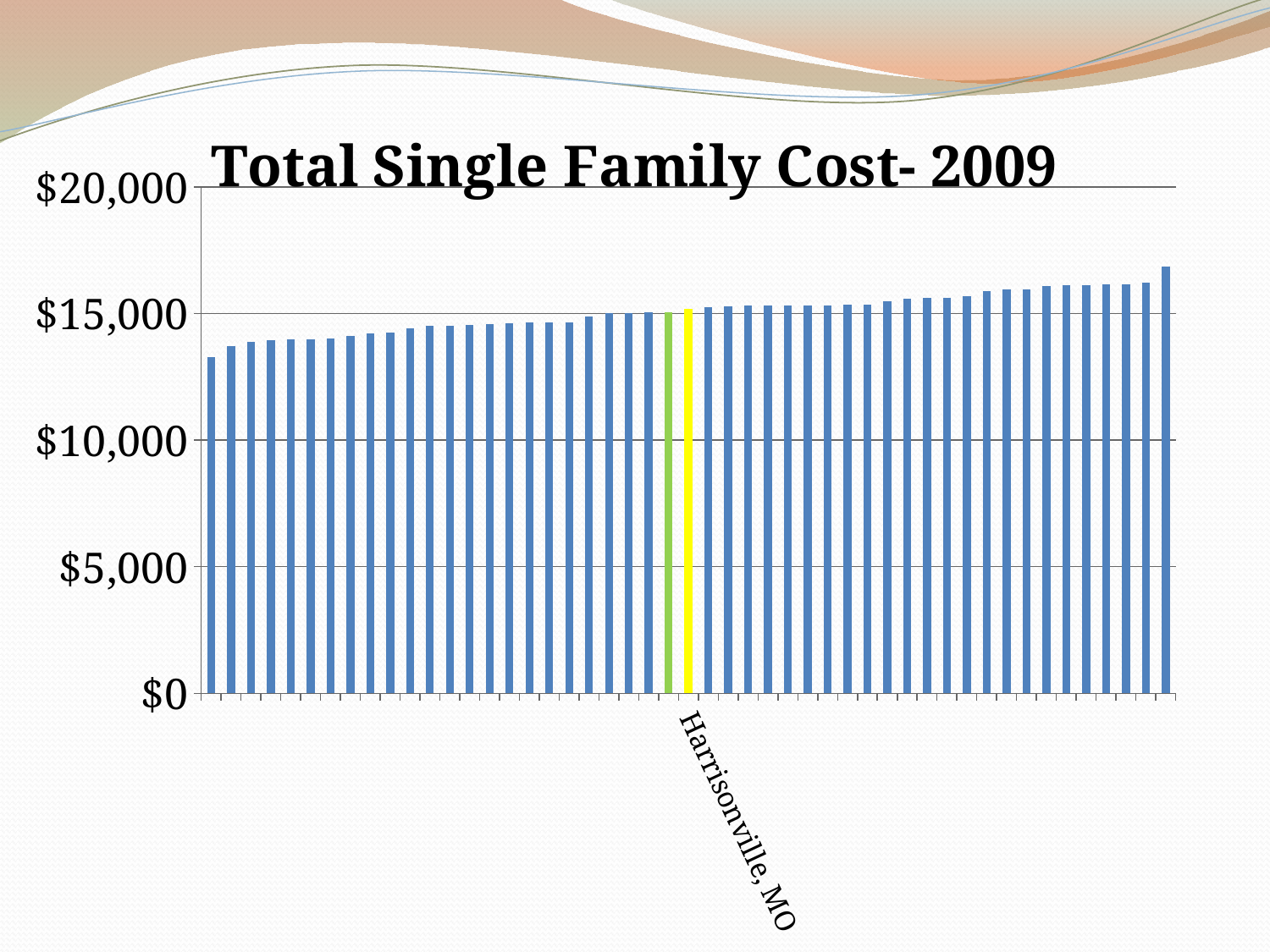
Is the tallest bar in the chart greater or less than $20,000? less What is the title of the chart? Total Single Family Cost- 2009 Which is larger, the value for Harrisonville, MO or the value of the leftmost bar? Harrisonville, MO Which category is labelled on the x axis of the chart? Harrisonville, MO Is the tallest bar in the chart greater or less than $15,000? greater Which is larger, the value for Harrisonville, MO or the value of the rightmost bar? the rightmost bar Do the bar values generally rise or fall from left to right along the x axis? rise What kind of chart is shown on the slide? bar chart Is the value for Harrisonville, MO greater or less than $20,000? less